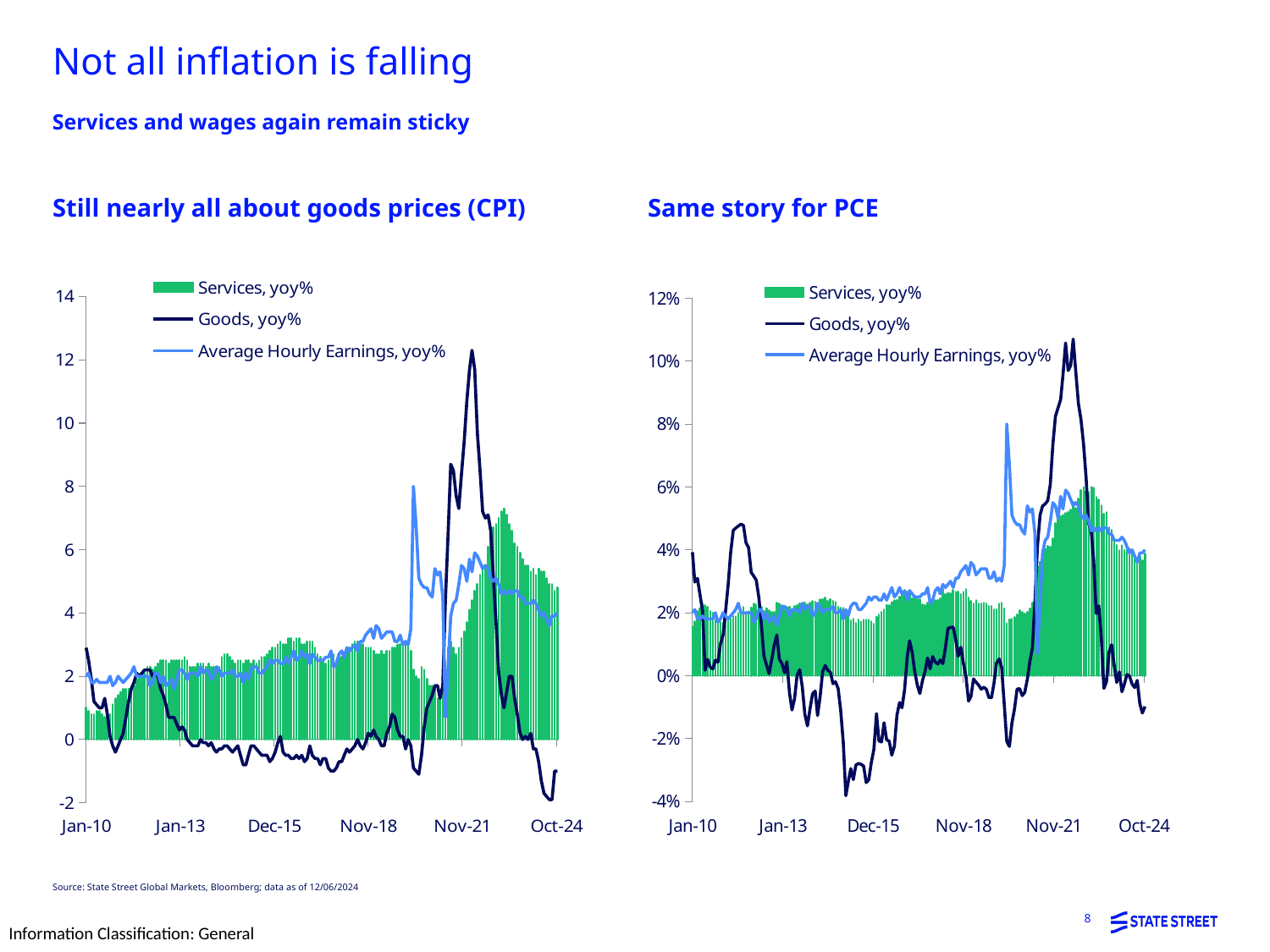
How many series does the legend of the right chart (PCE) list? 3 In the right chart (PCE), is the peak value of the Goods, yoy% line greater or less than 8%? greater How many series does the legend of the left chart (CPI) list? 3 In the left chart (CPI), which series reaches the highest value on the chart? Goods, yoy% In the right chart (PCE), is the lowest value of the Goods, yoy% line greater or less than -2%? less In the right chart (PCE), does the Goods, yoy% line rise or fall between its peak around 2022 and Oct-24? fall What is the title of the right chart? Same story for PCE In the left chart (CPI), which series is plotted as green bars? Services, yoy% In the left chart (CPI), is the peak value of the Goods, yoy% line greater or less than 10? greater What kind of chart is the left chart titled 'Still nearly all about goods prices (CPI)'? bar and line chart